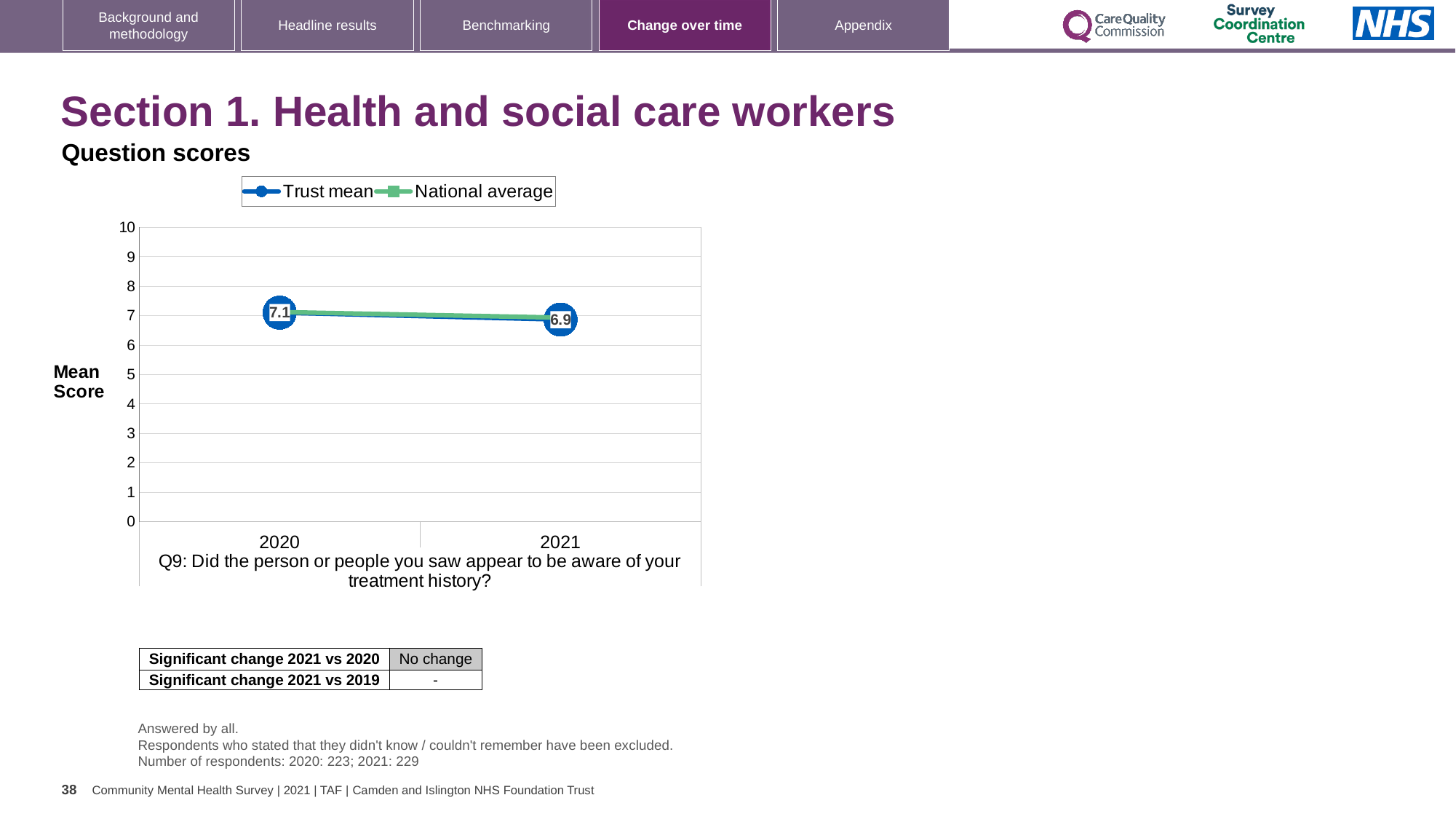
Which series is shown in green in the chart legend? National average Is the Trust mean value for 2020 greater or less than 8? less Which year has the higher Trust mean score, 2020 or 2021? 2020 How many years are shown on the x axis of the chart? 2 Is the National average value for 2021 greater or less than 5? greater What is the label of the y axis of the chart? Mean Score What is the difference between the Trust mean scores for 2020 and 2021? 0.2 What is the Trust mean score for 2021? 6.9 What is the Trust mean score for 2020? 7.1 What type of chart is shown on the slide? line chart Does the Trust mean score rise or fall from 2020 to 2021? fall How many series does the chart legend list? 2